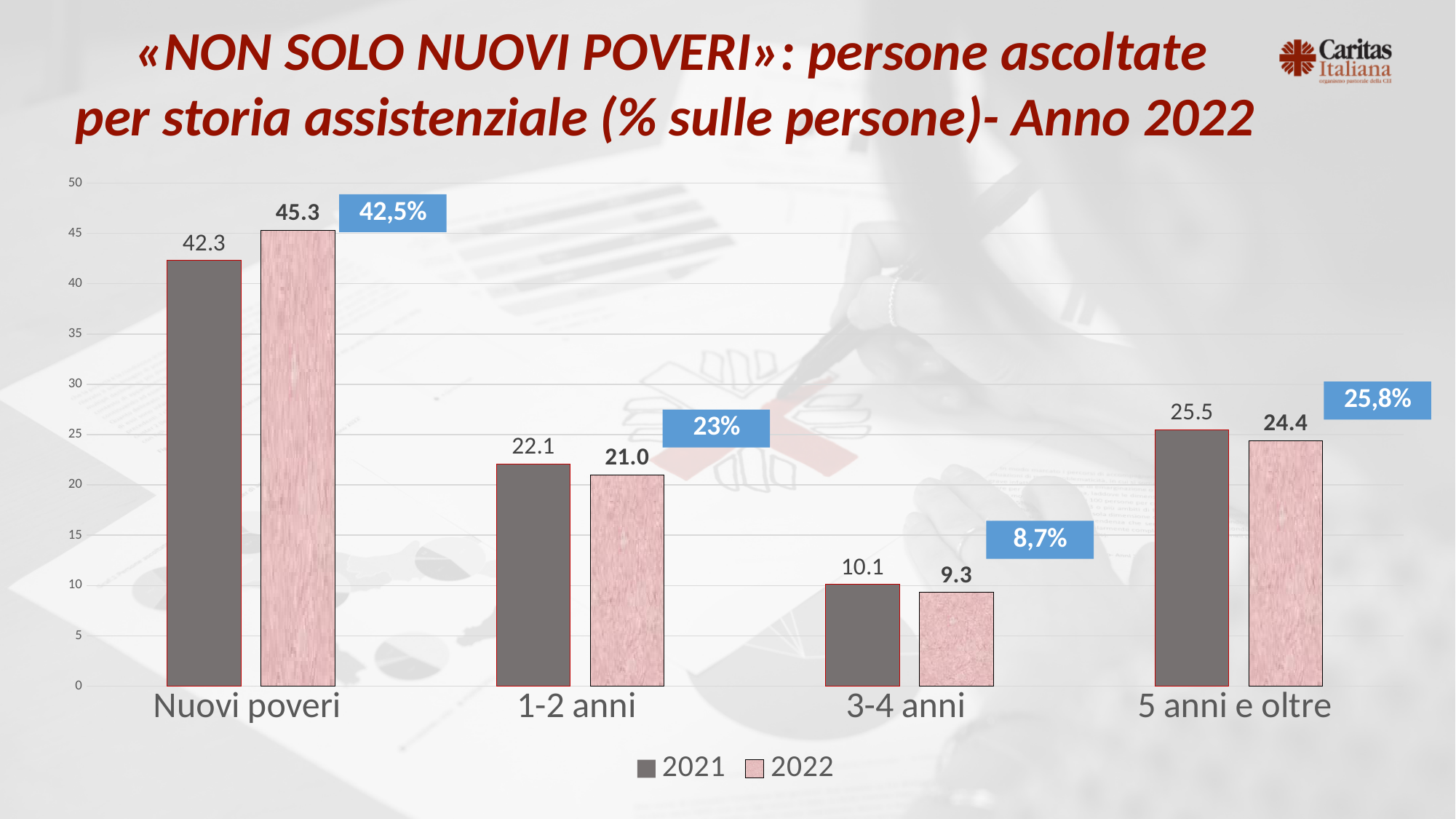
What percentage is shown in the blue box above the 3-4 anni bars? 8,7% How many series does the legend list? 2 What is the 2022 value for 5 anni e oltre? 24.4 How many categories are shown on the x axis? 4 What is the 2022 value for Nuovi poveri? 45.3 What is the 2021 value for 3-4 anni? 10.1 Which is larger for 1-2 anni, the 2021 value or the 2022 value? 2021 What is the difference between the 2022 and 2021 values for Nuovi poveri? 3.0 What kind of chart is shown on the slide? Bar chart What are the two series listed in the legend? 2021 and 2022 Which category has the lowest 2021 value? 3-4 anni Which category has the highest 2022 value? Nuovi poveri